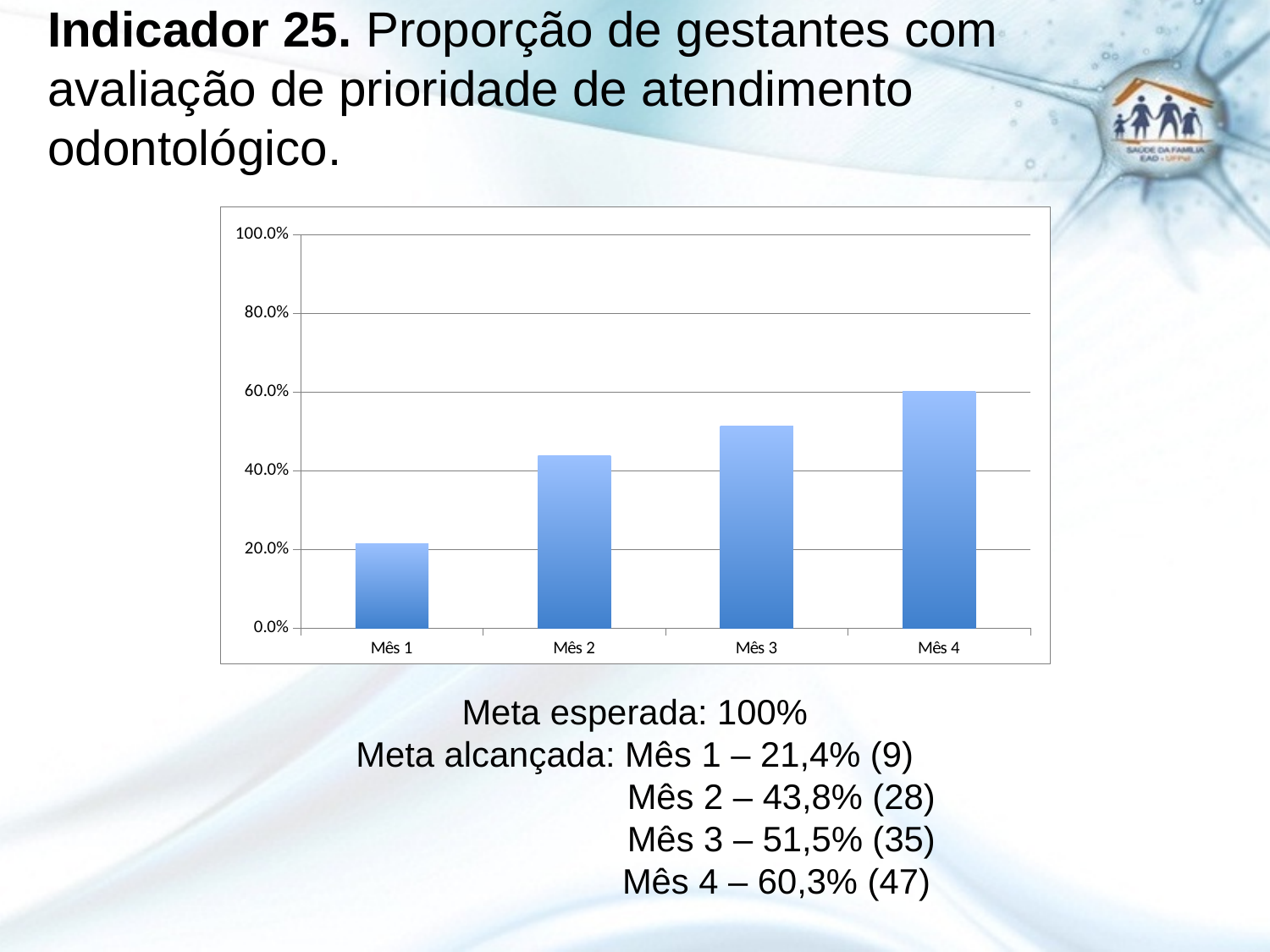
What kind of chart is shown on the slide? bar chart Which month has the highest bar in the chart? Mês 4 Which month has the lowest bar in the chart? Mês 1 What is the expected target (meta esperada) stated below the chart? 100% According to the text below the chart, what proportion was reached in Mês 2? 43,8% According to the text below the chart, what proportion was reached in Mês 4? 60,3% Is the value for Mês 1 greater or less than 40.0%? less Is the value for Mês 3 greater or less than 60.0%? less Do the values rise or fall from Mês 1 to Mês 4? rise Is the value for Mês 4 greater or less than 60.0%? greater How many bars (months) are plotted in the chart? 4 Which is larger, the value for Mês 2 or the value for Mês 3? Mês 3